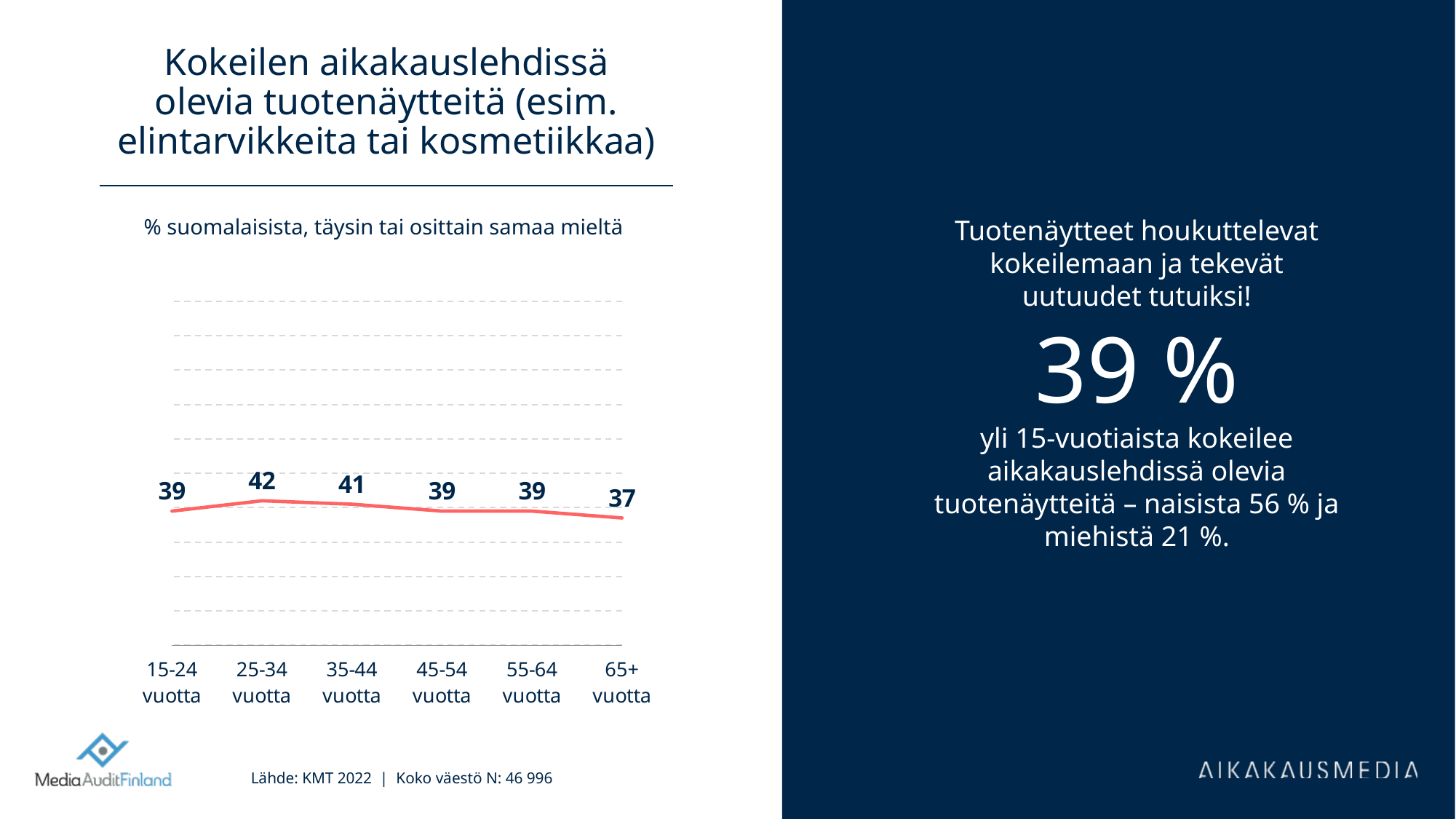
What is the title of the chart? Kokeilen aikakauslehdissä olevia tuotenäytteitä (esim. elintarvikkeita tai kosmetiikkaa) What is the value for the 25-34 vuotta age group? 42 Which age group has the highest value? 25-34 vuotta What is the difference between the values for 25-34 vuotta and 65+ vuotta? 5 What colour is the line in the chart? Red Which is larger, the value for 35-44 vuotta or the value for 45-54 vuotta? 35-44 vuotta How many age groups are plotted on the chart? 6 What kind of chart is shown on the slide? Line chart What is the value for the 65+ vuotta age group? 37 Which age group has the lowest value? 65+ vuotta What is the value for the 15-24 vuotta age group? 39 Do the values rise or fall from 35-44 vuotta to 65+ vuotta? Fall